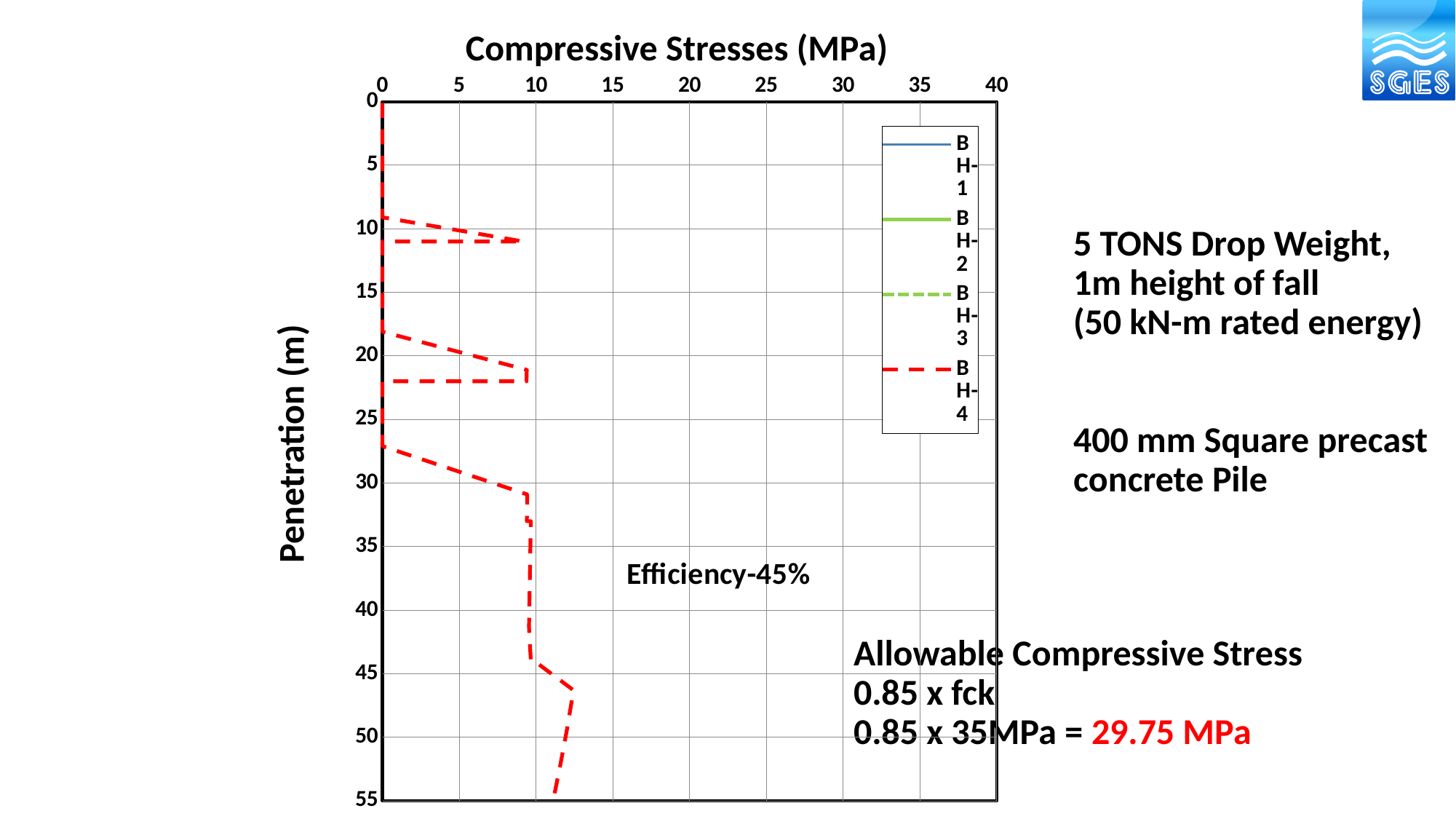
Is the BH-4 compressive stress at a penetration of 50 m greater or less than 15 MPa? less What is the label of the vertical axis of the chart? Penetration (m) Is the BH-4 compressive stress at a penetration of 40 m greater or less than 15 MPa? less Is the BH-4 compressive stress at a penetration of 35 m greater or less than 20 MPa? less What is the title of the horizontal axis of the chart? Compressive Stresses (MPa) How many series does the chart legend list? 4 What kind of chart is shown on the slide? line chart What is the maximum value shown on the horizontal axis of the chart? 40